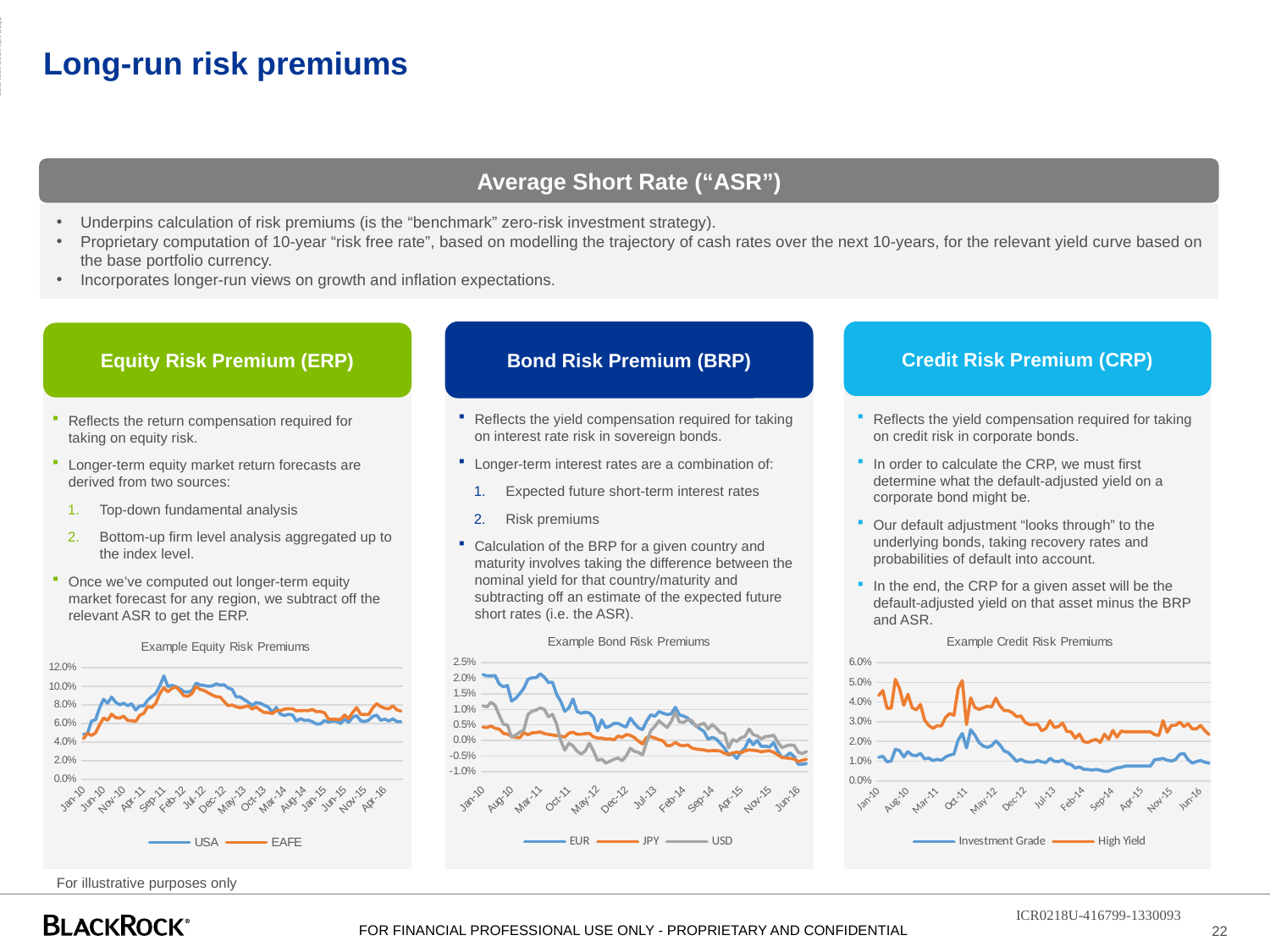
In the "Example Bond Risk Premiums" chart, does the EUR series overall rise or fall from Jan-10 to Jun-16? Fall In the "Example Credit Risk Premiums" chart, which series is higher at Jan-10, Investment Grade or High Yield? High Yield In the "Example Credit Risk Premiums" chart, does the High Yield series overall rise or fall from Jan-10 to Jun-16? Fall In the "Example Bond Risk Premiums" chart, which series is higher at Jan-10, EUR or JPY? EUR What kind of chart is the "Example Equity Risk Premiums" chart? Line chart How many series does the legend of the "Example Credit Risk Premiums" chart list? 2 In the "Example Equity Risk Premiums" chart, is the USA value at Jan-10 greater or less than 4.0%? greater How many series does the legend of the "Example Bond Risk Premiums" chart list? 3 In the "Example Equity Risk Premiums" chart, which two series are shown in the legend? USA and EAFE In the "Example Credit Risk Premiums" chart, is the High Yield value at Jan-10 greater or less than 3.0%? greater In the "Example Credit Risk Premiums" chart, is the Investment Grade value at Jan-10 greater or less than 2.0%? less